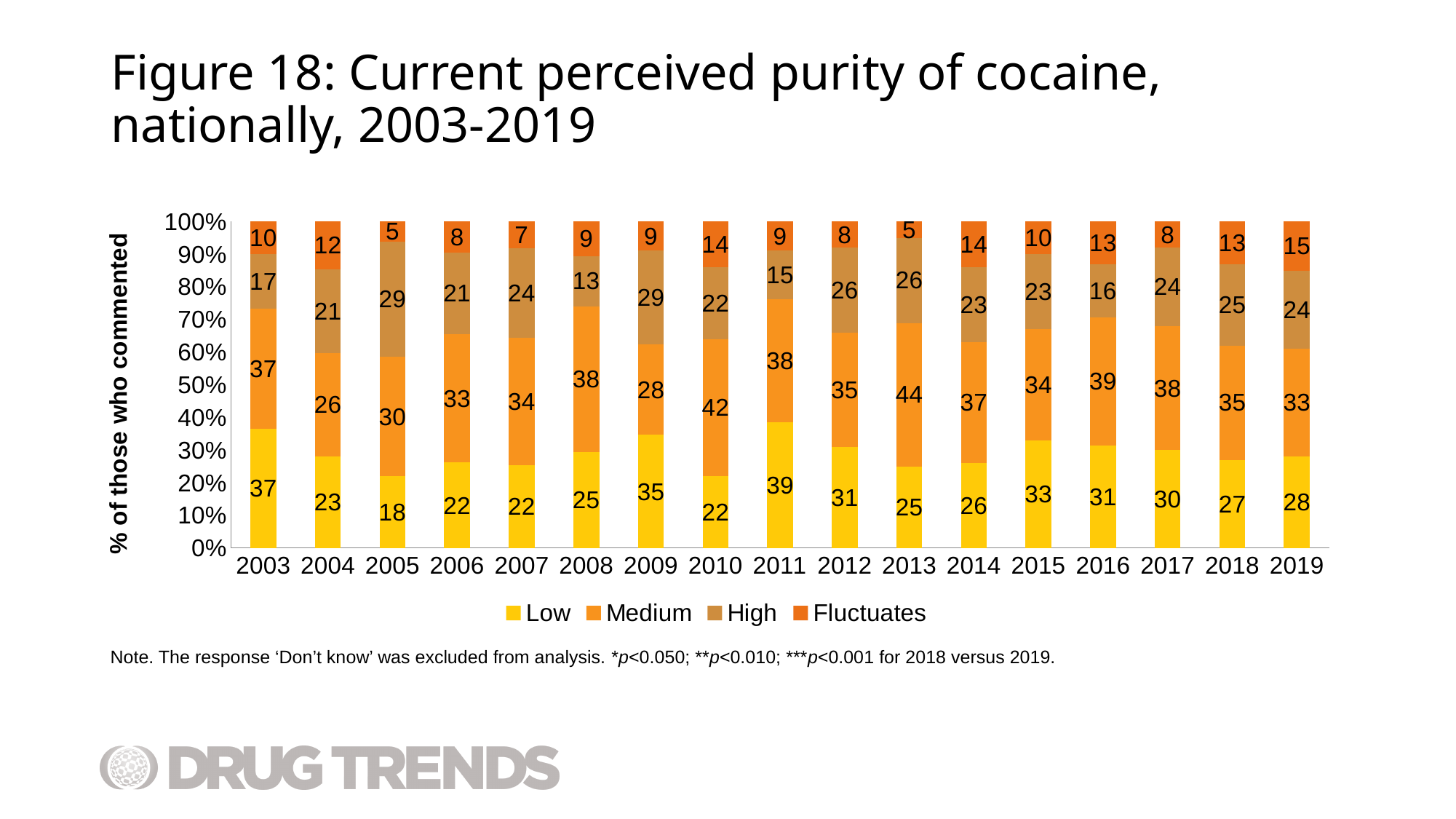
What is the value for Low in 2003? 37 What is the value for High in 2005? 29 What is the value for Fluctuates in 2019? 15 In which year is the Low value highest? 2011 How many years are shown on the x axis? 17 In which year is the Low value lowest? 2005 What is the difference between the Medium values in 2010 and 2009? 14 What kind of chart is this? Stacked bar chart Which is larger, the High value in 2008 or the High value in 2009? 2009 How many series does the legend list? 4 What is the label of the y axis? % of those who commented What is the value for Medium in 2013? 44